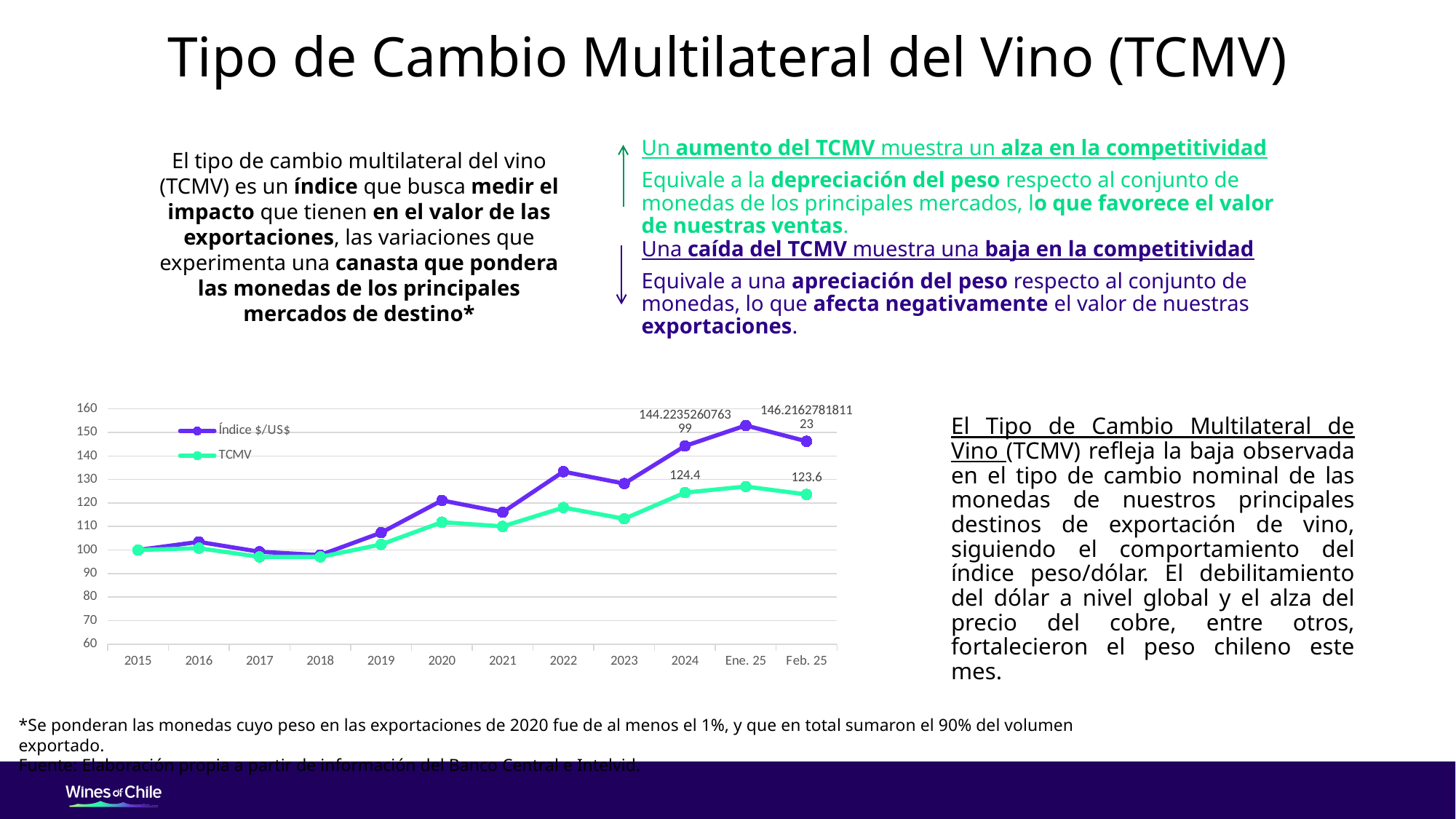
Is the TCMV value for 2019 greater or less than 110? less What kind of chart is shown on the slide? line chart How many points are plotted along the x axis of the chart? 12 Which series is higher in 2022, Índice $/US$ or TCMV? Índice $/US$ What is the difference between the TCMV value for 2024 and for Feb. 25? 0.8 At which x-axis point does the Índice $/US$ series reach its highest value? Ene. 25 What colour is the TCMV line in the chart? green What is the TCMV value for Feb. 25? 123.6 How many series does the chart legend list? 2 Is the Índice $/US$ value for Ene. 25 greater or less than 150? greater Which is larger, the TCMV value for 2024 or for Feb. 25? 2024 What is the TCMV value for 2024? 124.4